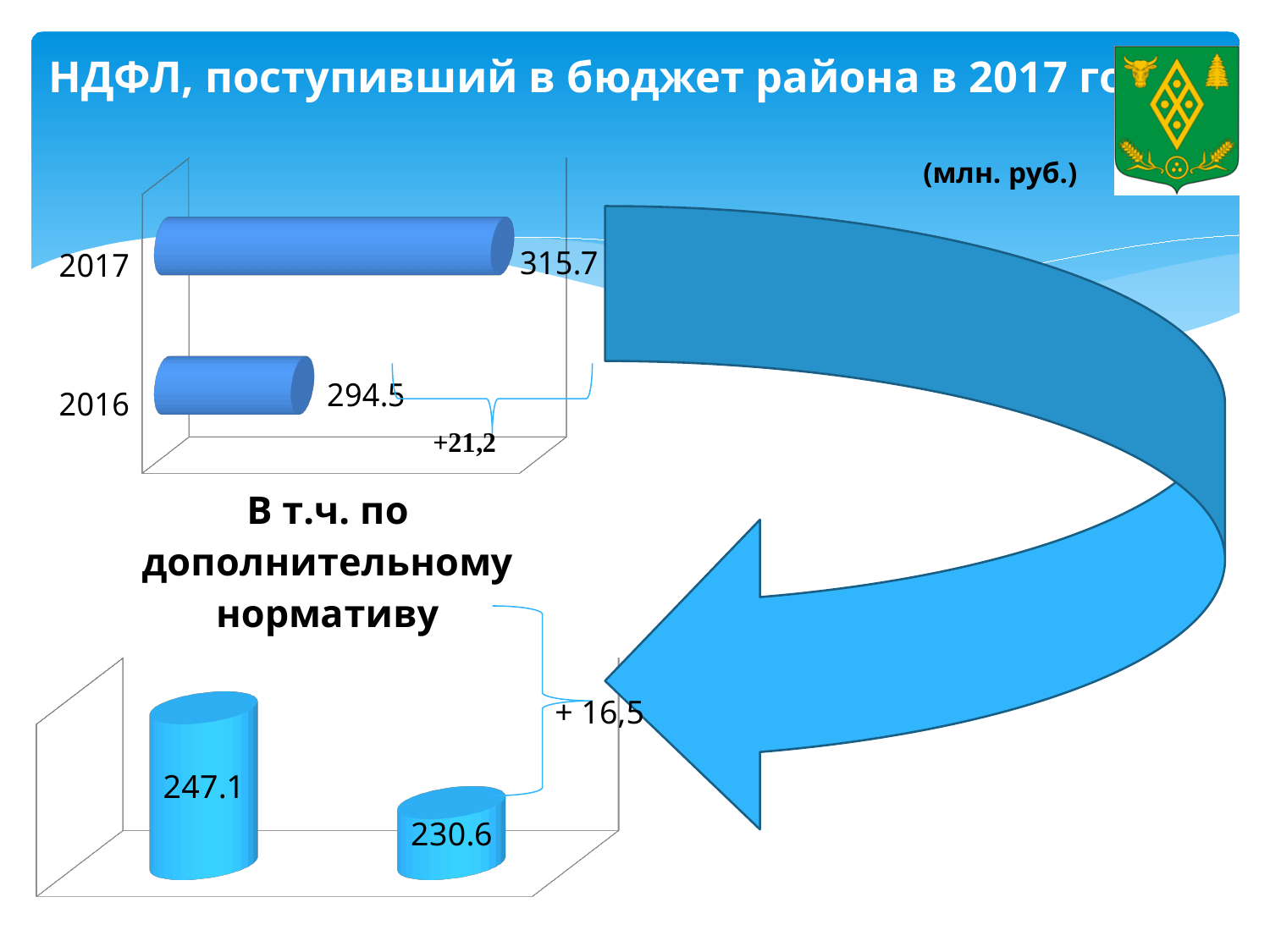
In the top chart, what is the value for 2016? 294.5 In the bottom chart titled 'В т.ч. по дополнительному нормативу', what is the value of the left bar? 247.1 In the top chart, what is the value for 2017? 315.7 What kind of chart is the top chart? bar chart In the bottom chart titled 'В т.ч. по дополнительному нормативу', which bar is larger, the left or the right? left In the top chart, how many bars are plotted? 2 In the top chart, what is the difference between the 2017 and 2016 values? 21.2 In the top chart, which year has the higher value? 2017 In the bottom chart titled 'В т.ч. по дополнительному нормативу', what is the difference between the left and right bars? 16.5 In the bottom chart titled 'В т.ч. по дополнительному нормативу', what is the value of the right bar? 230.6 In the top chart, which year has the lower value? 2016 What unit is stated for the values on the slide? млн. руб.